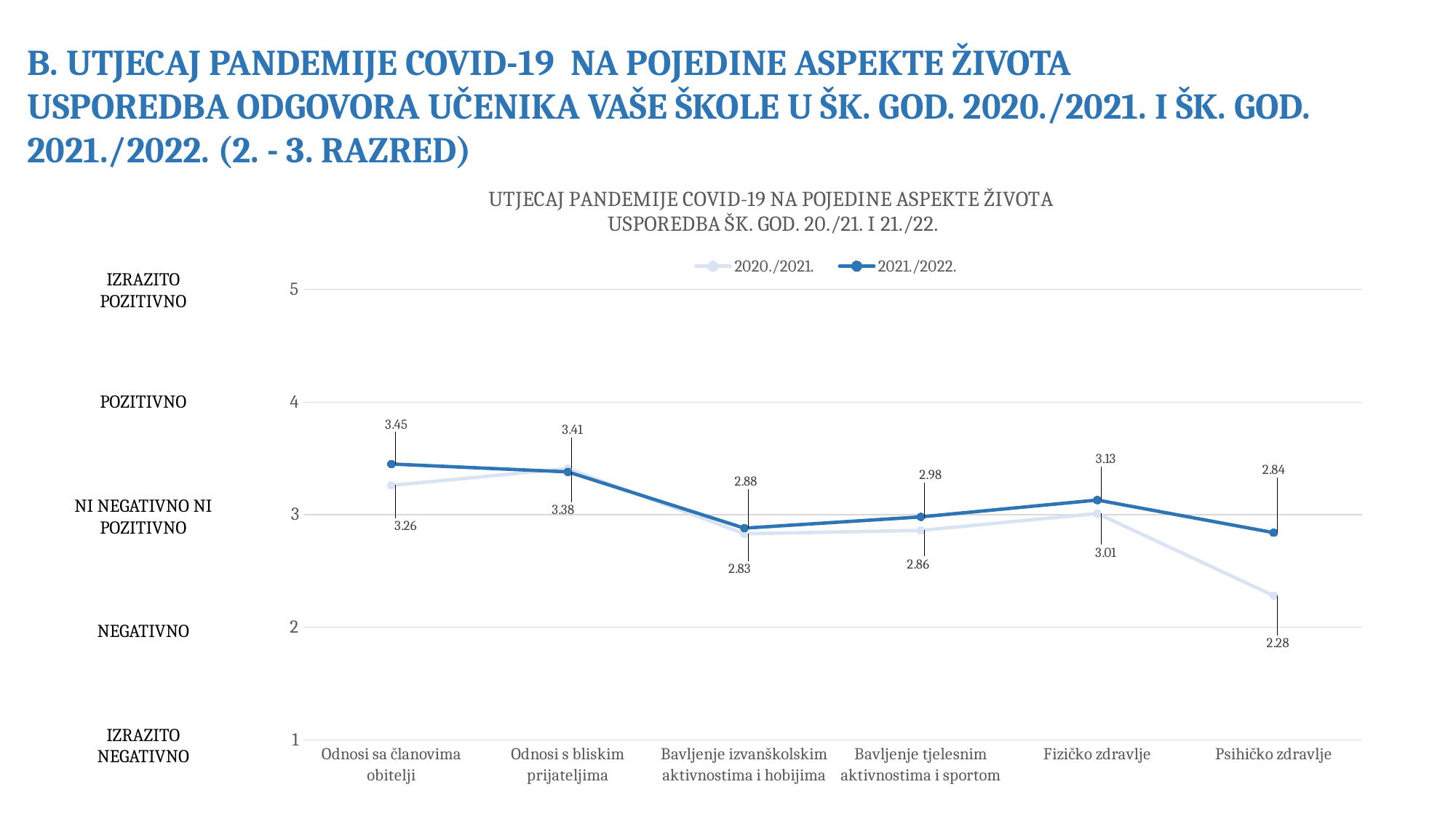
What is the difference between the 2021./2022. and 2020./2021. values for Psihičko zdravlje? 0.56 How many categories are shown on the x axis? 6 What is the 2021./2022. value for Psihičko zdravlje? 2.84 How many series does the legend list? 2 Is the 2020./2021. value for Psihičko zdravlje greater or less than 3? less For Fizičko zdravlje, which series has the larger value, 2020./2021. or 2021./2022.? 2021./2022. Which category has the lowest 2020./2021. value? Psihičko zdravlje What is the 2020./2021. value for Psihičko zdravlje? 2.28 What is the 2021./2022. value for Bavljenje tjelesnim aktivnostima i sportom? 2.98 What is the 2020./2021. value for Odnosi sa članovima obitelji? 3.26 What type of chart is shown on the slide? Line chart Which category has the highest 2021./2022. value? Odnosi sa članovima obitelji